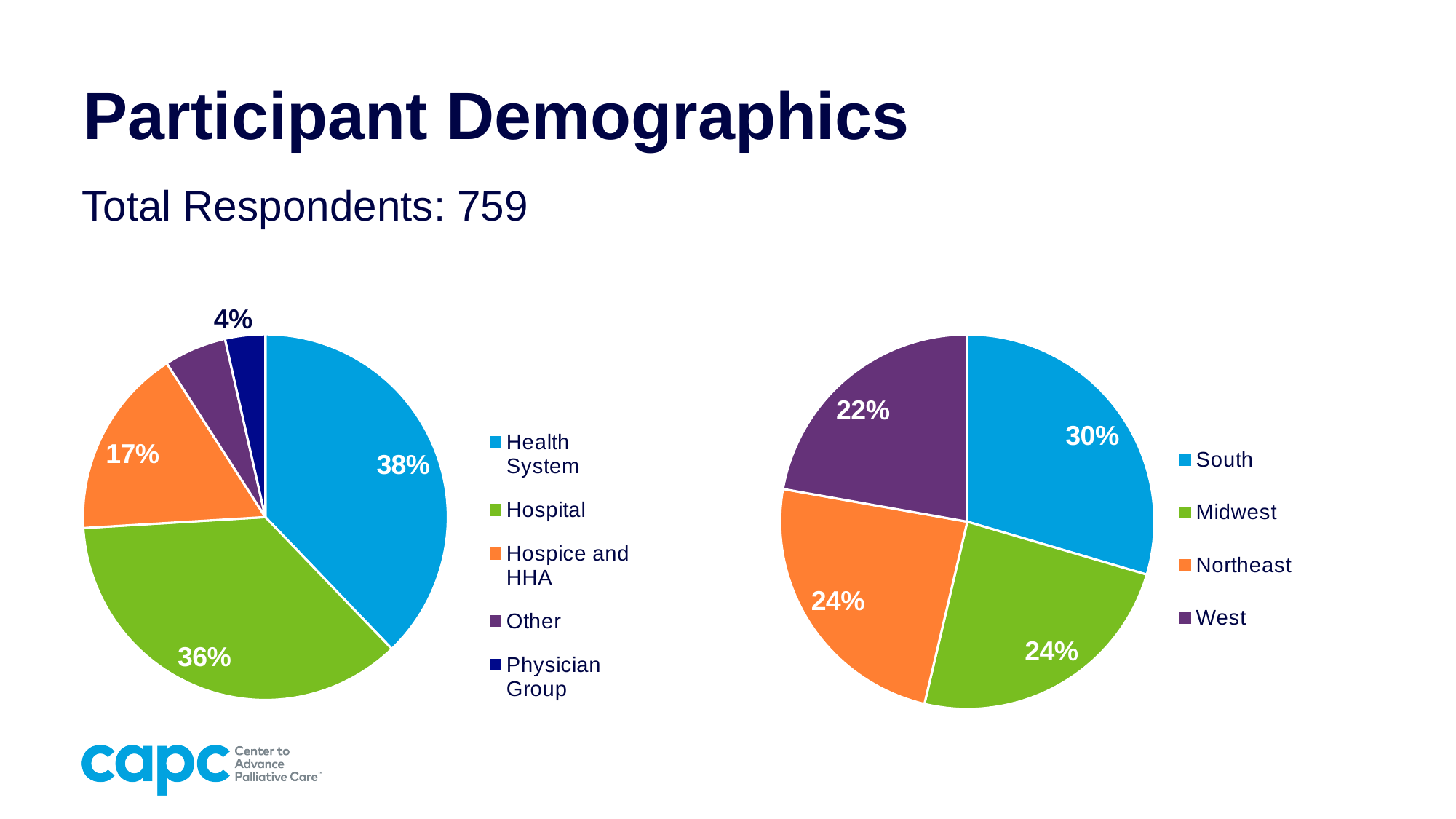
On the right pie chart, what percentage is labelled for the West? 22% What type of chart is shown on the right side of the slide? Pie chart On the left pie chart, which category has the smallest slice? Physician Group On the left pie chart, what share of respondents are from a Health System? 38% On the left pie chart, what percentage is labelled for Hospice and HHA? 17% On the right pie chart, what is the difference between the South and Northeast shares? 6% How many categories does the legend of the left pie chart list? 5 On the right pie chart, which region has the largest share? South On the right pie chart, is the share for the South larger or smaller than the share for the West? larger On the left pie chart, which category has the largest slice? Health System On the right pie chart, what share of respondents are from the South? 30% On the left pie chart, what is the difference between the Health System and Hospital shares? 2%